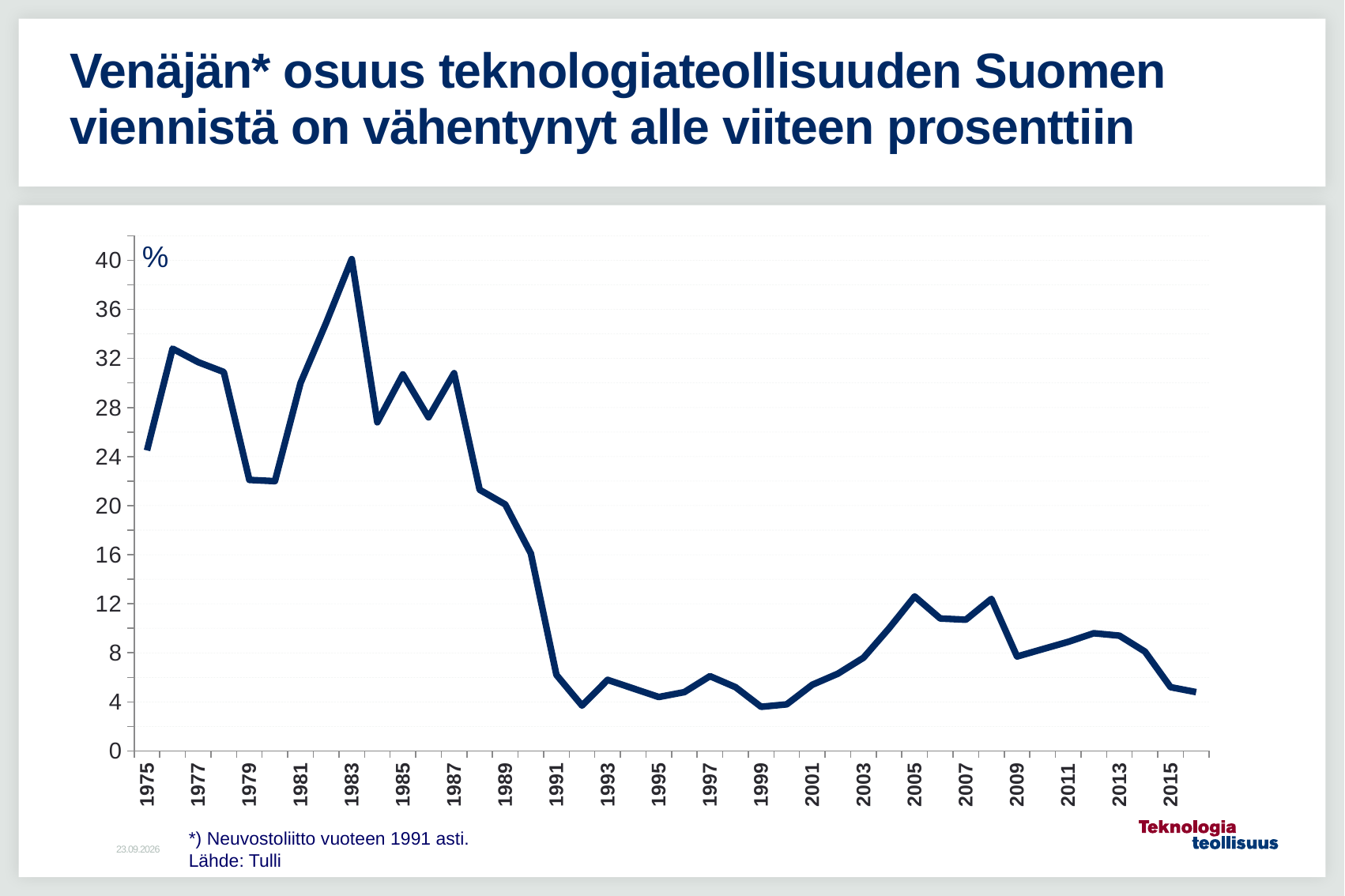
In which year does the line reach its highest value? 1983 What kind of chart is shown on the slide? line chart What source is cited below the chart? Tulli Is the value for 2015 greater or less than 8? less Is the value for 1991 greater or less than 8? less Which year has the larger value, 1983 or 1985? 1983 Is the value for 1983 greater or less than 36? greater What unit is shown at the top of the y axis? % Does the line rise or fall between 1987 and 1992? fall Which year has the larger value, 2005 or 2015? 2005